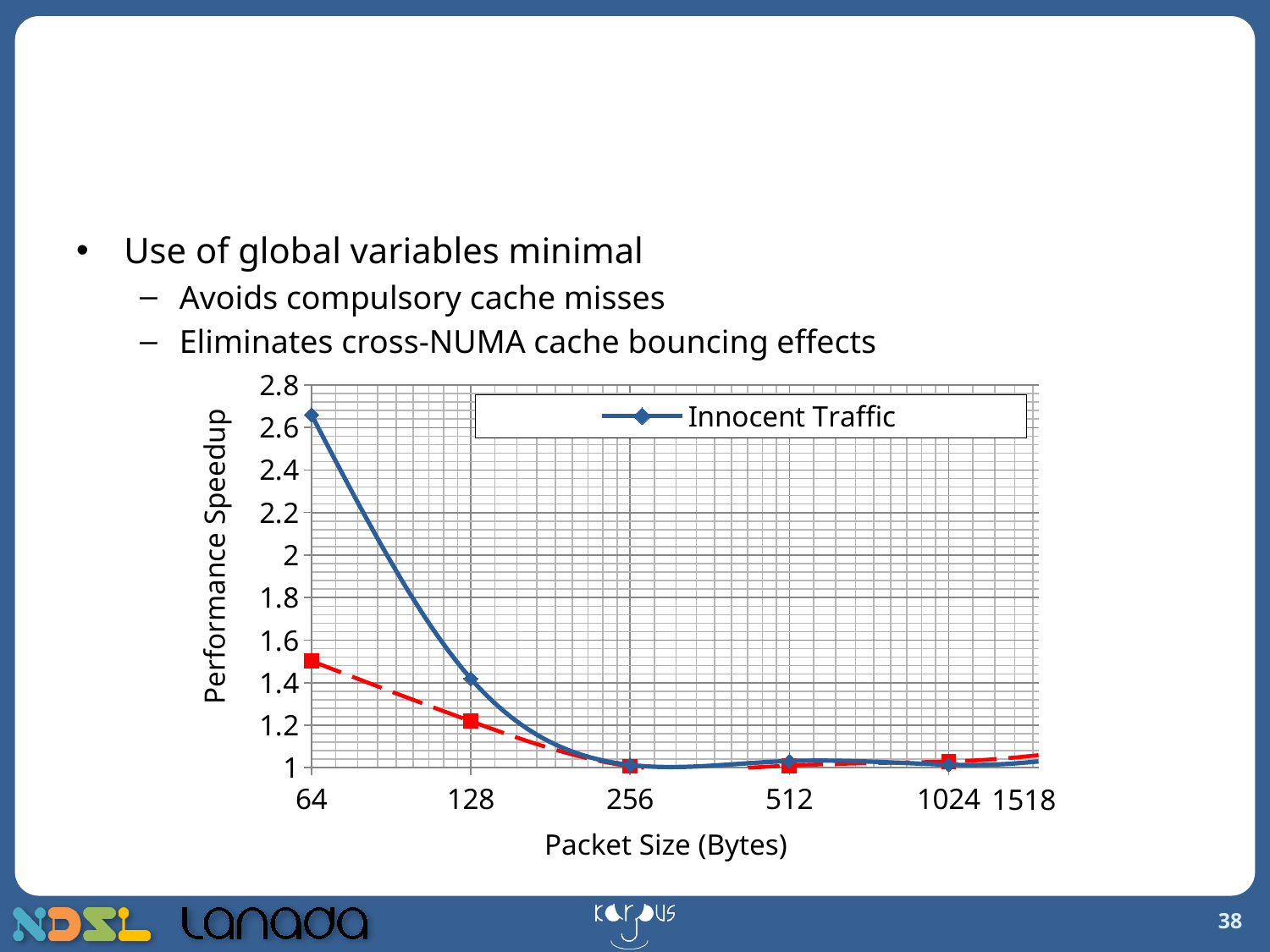
What kind of chart is shown on the slide? line chart Is the red dashed series' performance speedup at a packet size of 128 bytes greater or less than 1.4? less How many series does the chart's legend list? 1 How many packet sizes are labelled on the x axis of the chart? 6 Is the red dashed series' performance speedup at a packet size of 64 bytes greater or less than 1.4? greater At which packet size is the Innocent Traffic performance speedup highest? 64 Does the Innocent Traffic performance speedup rise or fall as packet size increases from 64 to 256 bytes? fall Is the Innocent Traffic performance speedup at a packet size of 128 bytes greater or less than 1.6? less What is the title of the x axis of the chart? Packet Size (Bytes) At a packet size of 64 bytes, which series has the higher performance speedup: Innocent Traffic (blue) or the red dashed series? Innocent Traffic What is the title of the y axis of the chart? Performance Speedup